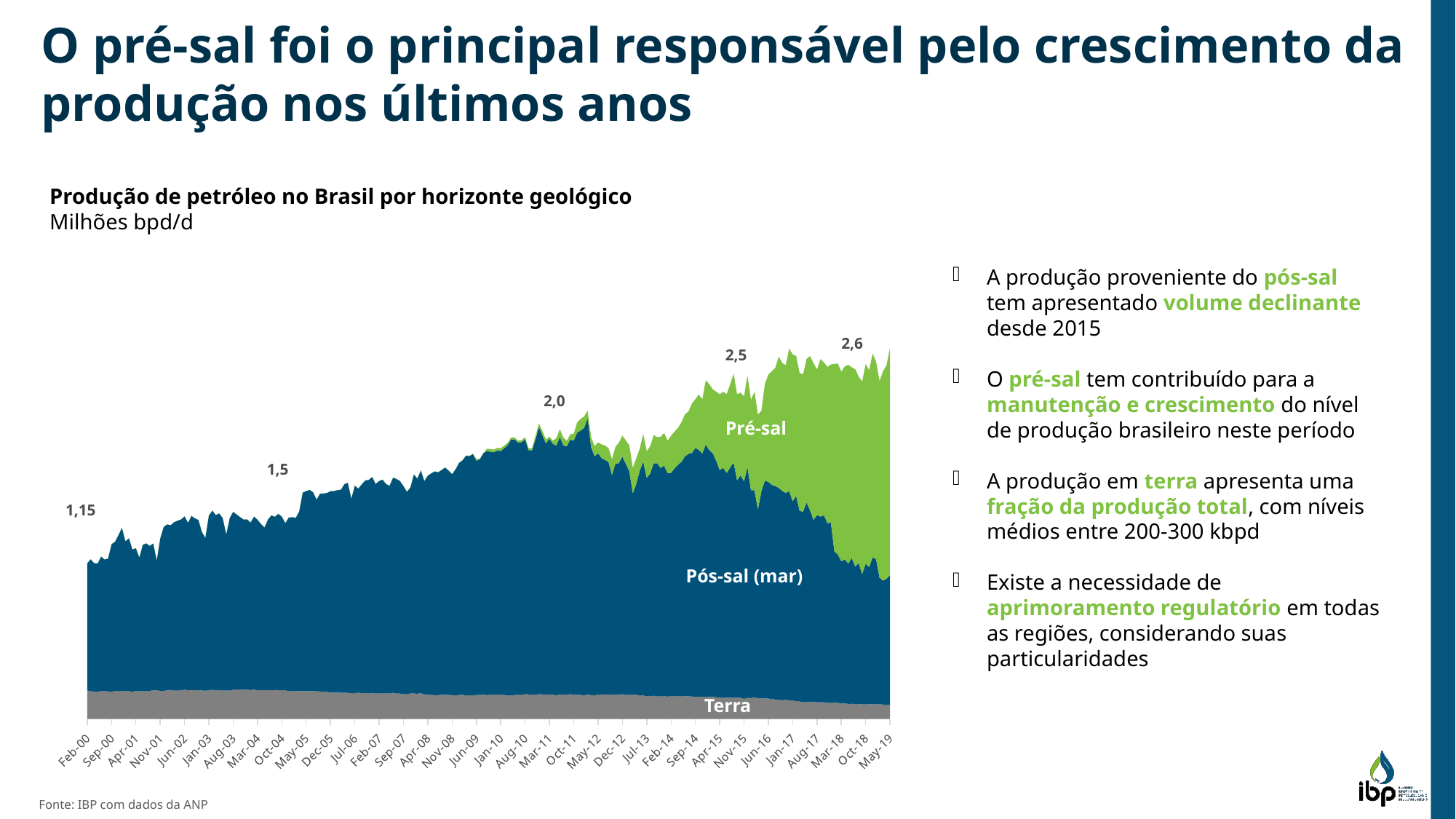
What is the difference between the highest data label (2,6) and the lowest data label (1,15)? 1,45 What is the first data label shown on the chart, at the start of the series in Feb-00? 1,15 What unit is the chart measured in? Milhões bpd/d How many data labels are printed on the chart? 5 Which is larger, the data label 2,5 or the data label 2,0? 2,5 How many series (geological horizons) are shown in the chart? 3 What is the difference between the data labels 2,0 and 1,5? 0,5 Which series is shown at the bottom of the stacked area chart? Terra What kind of chart is shown on the slide? Area chart What is the highest data label printed on the chart? 2,6 What is the lowest data label printed on the chart? 1,15 Does total oil production rise or fall from Feb-00 to May-19? Rise